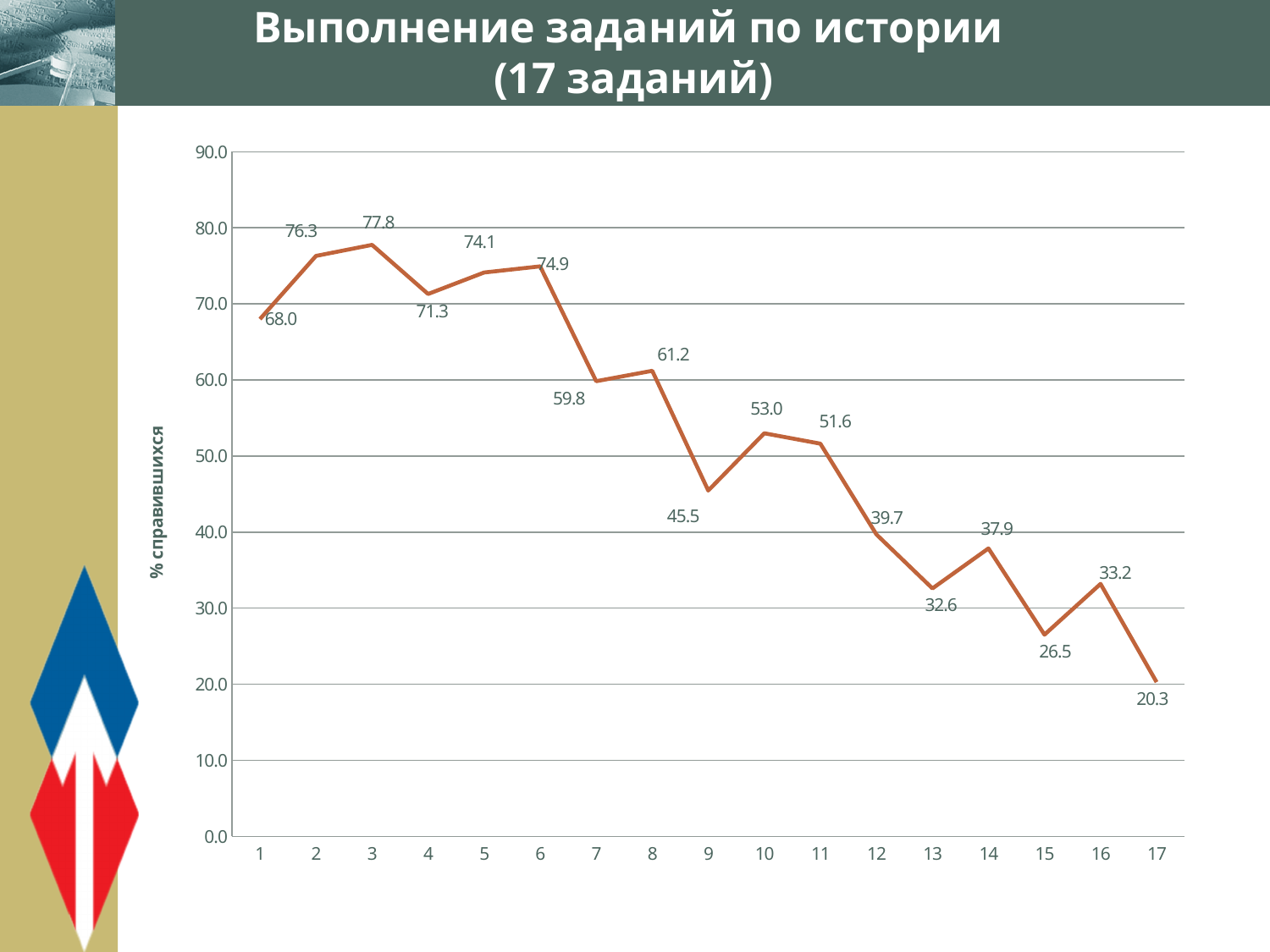
Which task has the lowest value? 17 Which has the larger value, task 10 or task 11? Task 10 What is the label of the vertical axis? % справившихся Which task has the highest value? 3 Is the value for task 7 greater or less than 60.0? less What is the value for task 1? 68.0 What type of chart is shown on the slide? Line chart What is the value for task 14? 37.9 What is the difference between the values for task 3 and task 17? 57.5 Overall, do the values rise or fall from task 1 to task 17? Fall How many tasks (points) are plotted along the x axis? 17 What is the value for task 9? 45.5